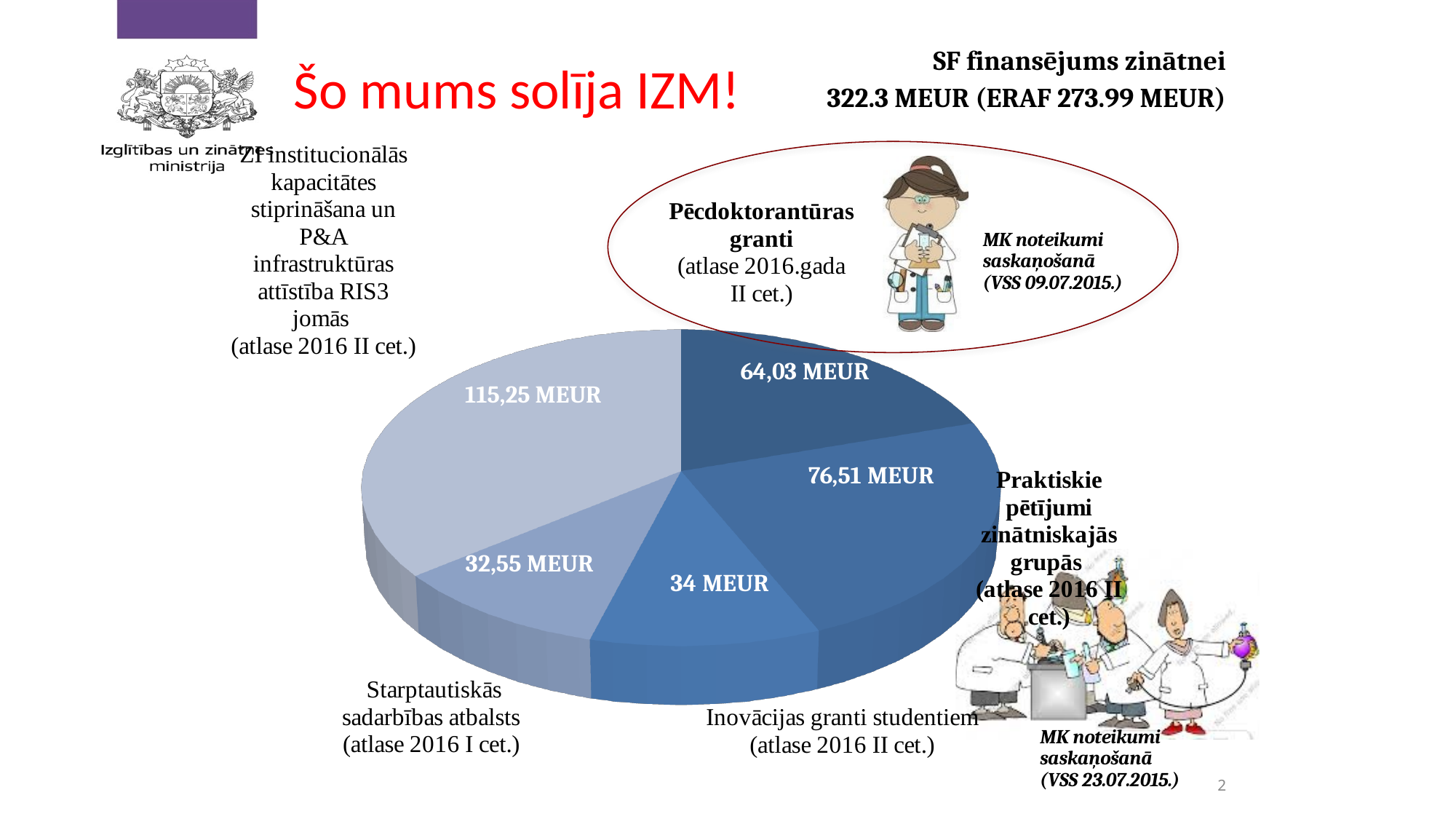
What is the value of the Inovācijas granti studentiem slice? 34 MEUR Which slice of the pie chart has the largest value? ZI institucionālās kapacitātes stiprināšana un P&A infrastruktūras attīstība RIS3 jomās (115,25 MEUR) What is the value of the Starptautiskās sadarbības atbalsts slice? 32,55 MEUR Which slice of the pie chart has the smallest value? Starptautiskās sadarbības atbalsts (32,55 MEUR) What is the difference between the largest slice (115,25 MEUR) and the Praktiskie pētījumi zinātniskajās grupās slice (76,51 MEUR)? 38,74 MEUR What is the value of the Praktiskie pētījumi zinātniskajās grupās slice? 76,51 MEUR What type of chart is shown on the slide? Pie chart What is the value of the ZI institucionālās kapacitātes stiprināšana un P&A infrastruktūras attīstība RIS3 jomās slice? 115,25 MEUR Which is larger: the Inovācijas granti studentiem slice or the Starptautiskās sadarbības atbalsts slice? Inovācijas granti studentiem (34 MEUR) What is the difference between the Praktiskie pētījumi zinātniskajās grupās slice and the Pēcdoktorantūras granti slice? 12,48 MEUR How many slices does the pie chart have? 5 What is the value of the Pēcdoktorantūras granti slice in the pie chart? 64,03 MEUR